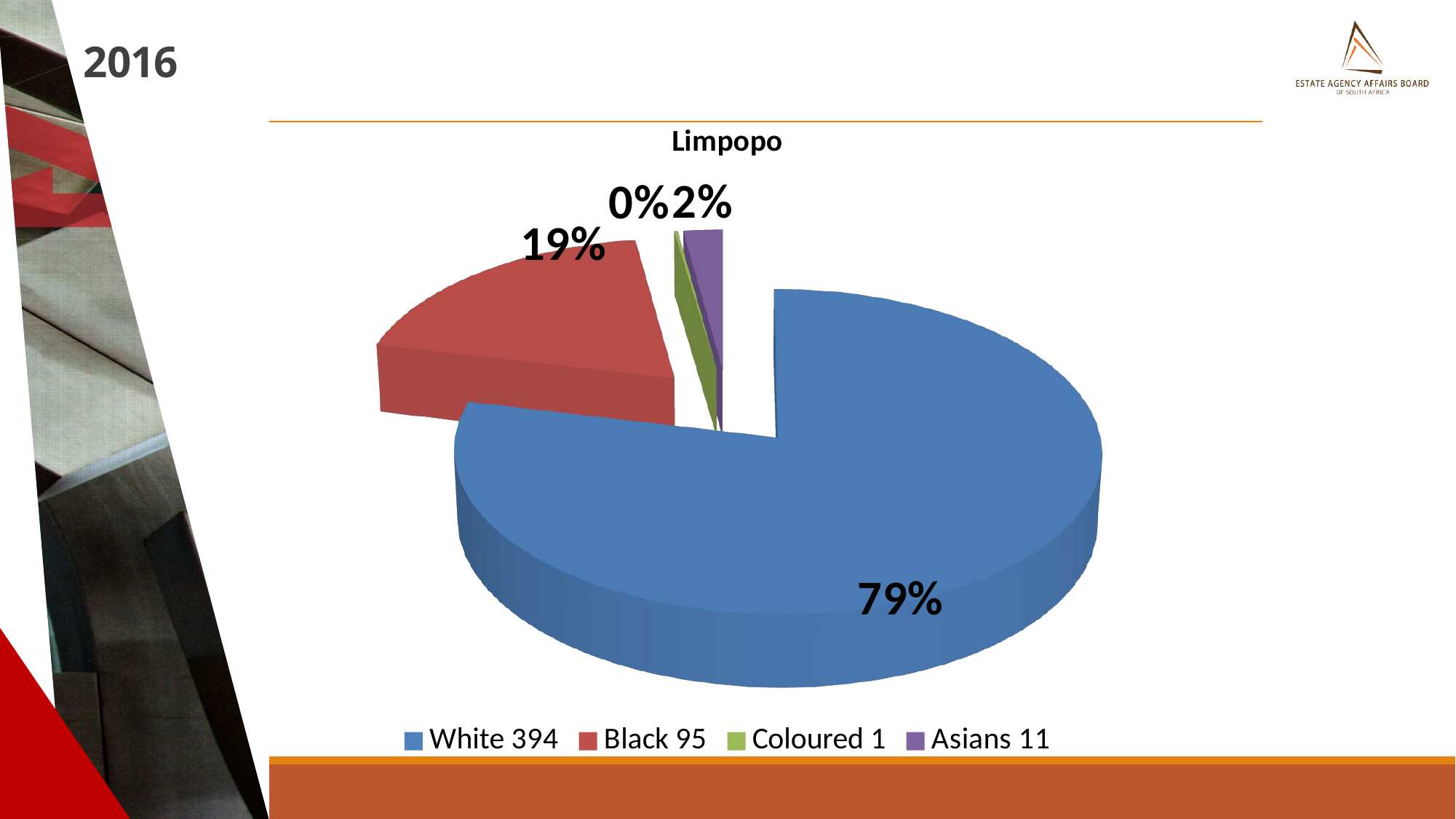
What percentage share does the Coloured slice have? 0% How many slices does the pie chart have? 4 What percentage share does the White slice have? 79% What is the difference in percentage points between the White and Black slices? 60 Which category has the largest share of the pie? White What colour is the slice for Black? red What is the title of the chart? Limpopo What kind of chart is shown on the slide? pie chart What percentage share does the Asians slice have? 2% Which category has the smallest share of the pie? Coloured Which is larger, the Black slice or the Asians slice? Black